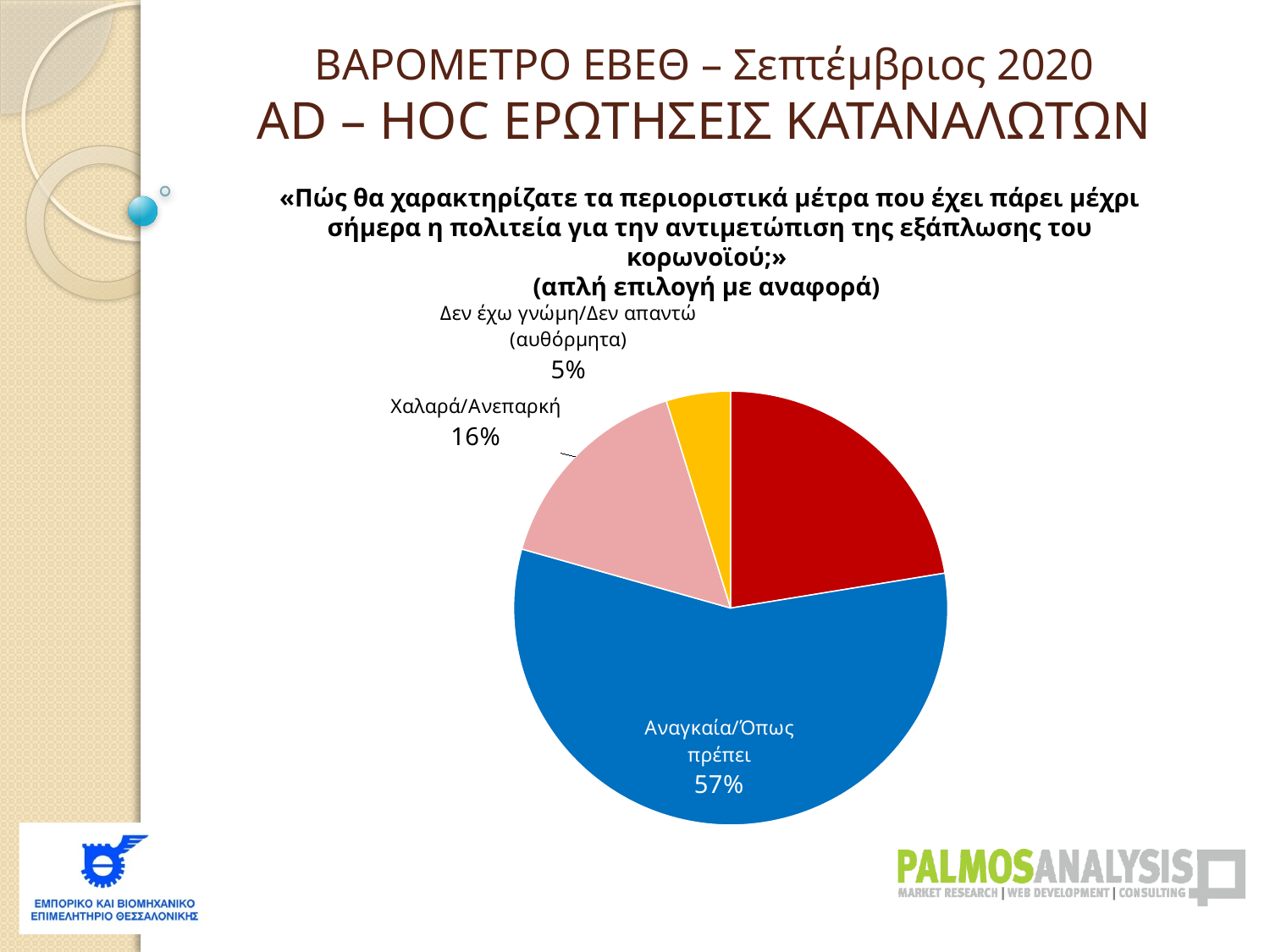
What share of respondents answered Δεν έχω γνώμη/Δεν απαντώ (αυθόρμητα)? 5% What share of respondents answered Αναγκαία/Όπως πρέπει? 57% How many slices does the pie chart have? 4 Which labelled response has the largest share of the pie? Αναγκαία/Όπως πρέπει What is the difference in percentage points between Αναγκαία/Όπως πρέπει and Χαλαρά/Ανεπαρκή? 41 What share of respondents answered Χαλαρά/Ανεπαρκή? 16% What colour is the slice for Αναγκαία/Όπως πρέπει? blue What kind of chart is shown on the slide? pie chart What colour is the slice for Δεν έχω γνώμη/Δεν απαντώ? yellow Which is larger, the share for Χαλαρά/Ανεπαρκή or the share for Δεν έχω γνώμη/Δεν απαντώ? Χαλαρά/Ανεπαρκή Which labelled response has the smallest share of the pie? Δεν έχω γνώμη/Δεν απαντώ (αυθόρμητα) What is the difference in percentage points between Χαλαρά/Ανεπαρκή and Δεν έχω γνώμη/Δεν απαντώ? 11